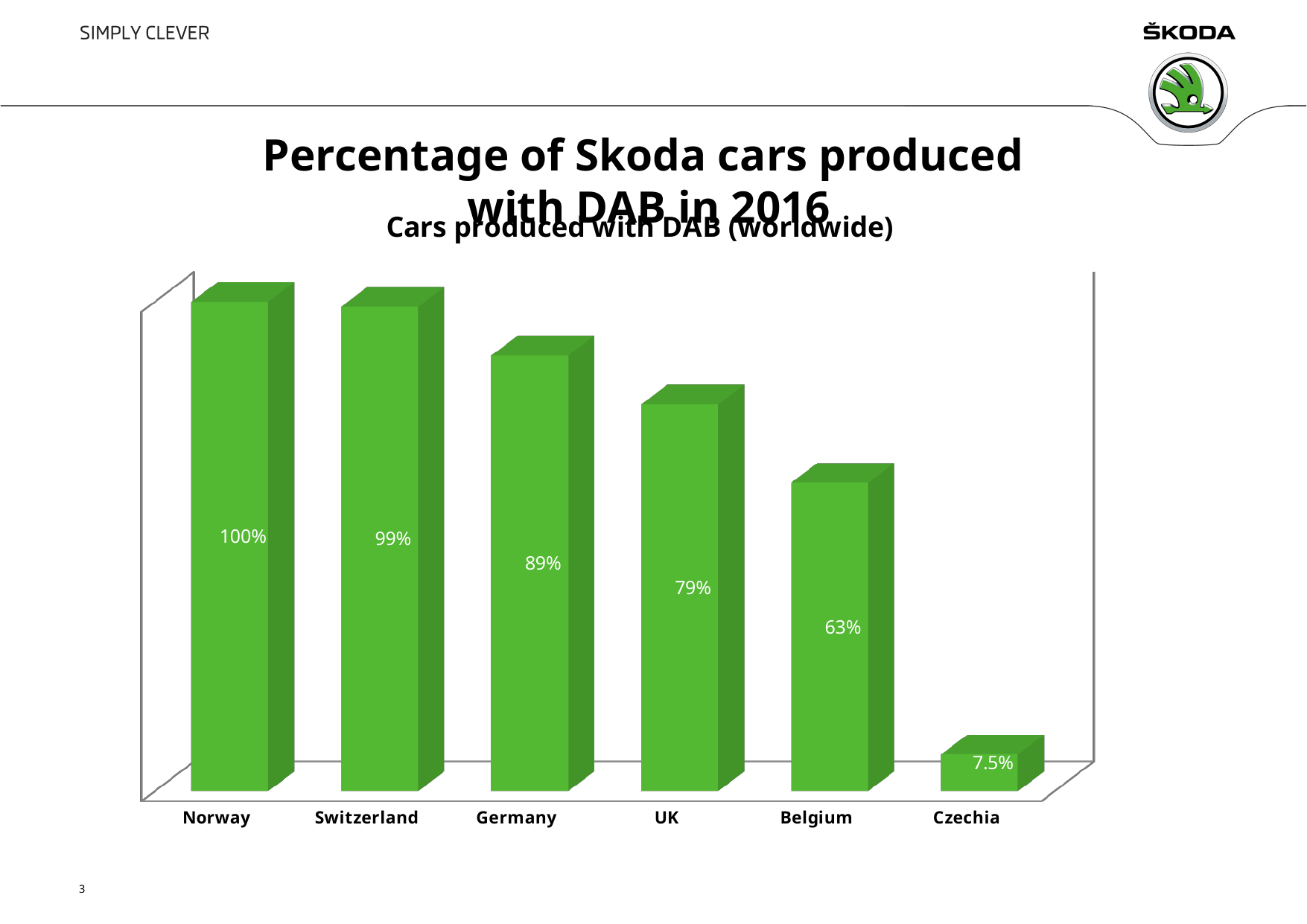
Which has a higher value, the UK or Belgium? UK What is the difference between the values for Switzerland and Belgium? 36% Do the values rise or fall from left to right across the countries? Fall Which country has the highest percentage of cars produced with DAB? Norway What is the value shown for Czechia? 7.5% What kind of chart is shown on the slide? Bar chart What percentage of Skoda cars were produced with DAB in Norway? 100% Which country has the lowest percentage of cars produced with DAB? Czechia What is the value shown for Germany? 89% How many countries are shown in the chart? 6 What is the value shown for Belgium? 63% What is the difference between the values for Germany and the UK? 10%